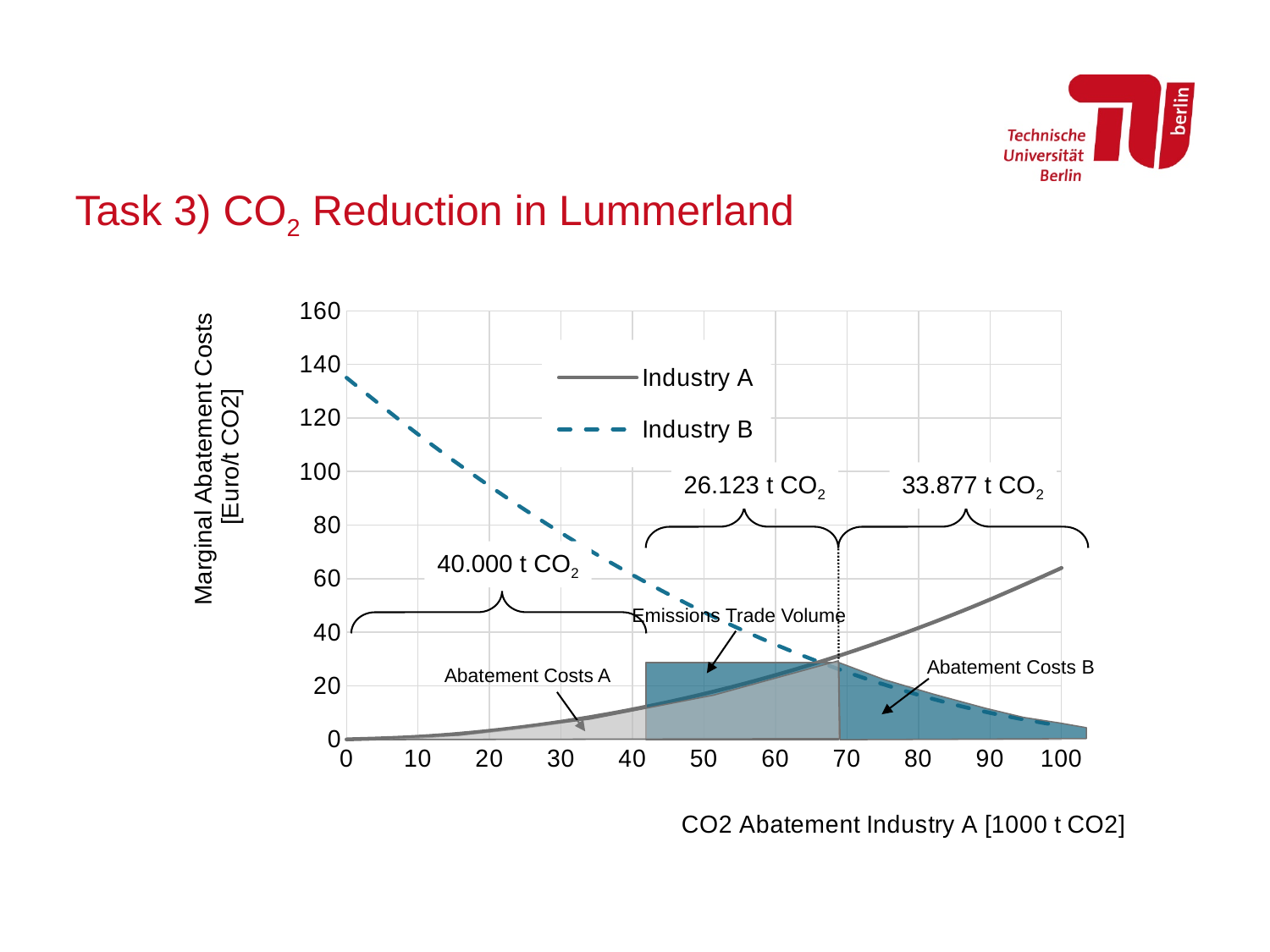
What kind of chart is shown on the slide? line chart Is the value for Industry B at 0 on the x axis greater or less than 120? greater Do the values for Industry B rise or fall as CO2 abatement increases along the x axis? fall Is the value for Industry A at 100 on the x axis greater or less than 40? greater How many series does the legend list? 2 At 90 on the x axis, which series has the higher value, Industry A or Industry B? Industry A Is the value for Industry A at 20 on the x axis greater or less than 20? less Do the values for Industry A rise or fall as CO2 abatement increases along the x axis? rise Which series are listed in the legend? Industry A and Industry B At 20 on the x axis, which series has the higher value, Industry A or Industry B? Industry B What is the title of the y axis? Marginal Abatement Costs [Euro/t CO2]